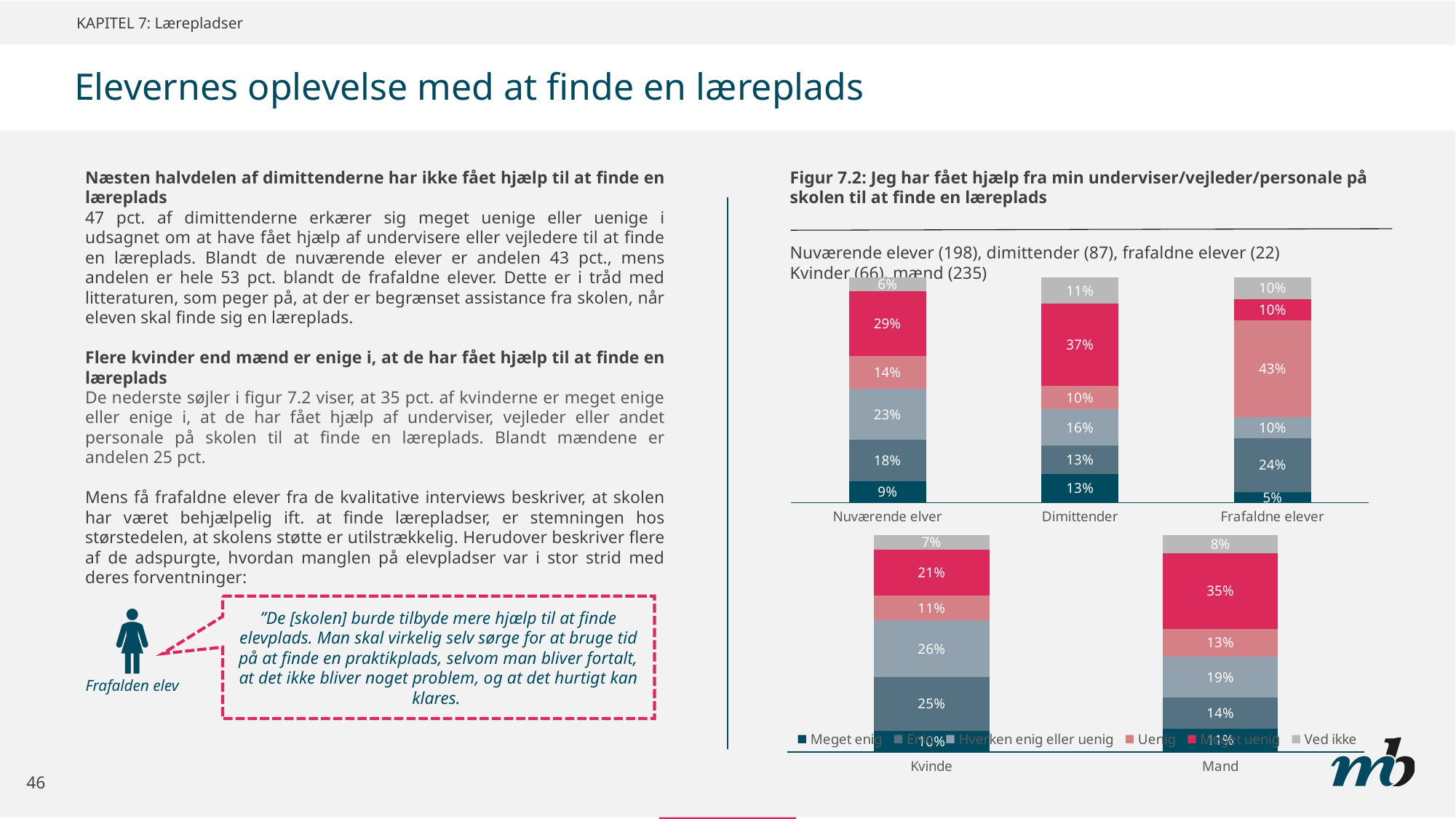
In the bottom chart, what is the 'Meget uenig' share for Mand? 35% How many series does the legend list? 6 In the top chart, which category has the lowest 'Meget enig' share? Frafaldne elever In the top chart, what is the 'Meget uenig' share for Dimittender? 37% In the bottom chart, what is the difference between the 'Meget uenig' shares for Mand and Kvinde? 14 percentage points In the top chart, which is larger: the 'Enig' share for Frafaldne elever or for Nuværende elever? Frafaldne elever In the top chart, which category has the highest 'Meget uenig' share? Dimittender In the bottom chart, what is the 'Hverken enig eller uenig' share for Kvinde? 26% What type of chart is used in Figur 7.2? Stacked bar chart How many categories are shown on the x axis of the top chart? 3 In the top chart, what is the 'Meget enig' share for Nuværende elever? 9% In the top chart, what is the 'Uenig' share for Frafaldne elever? 43%